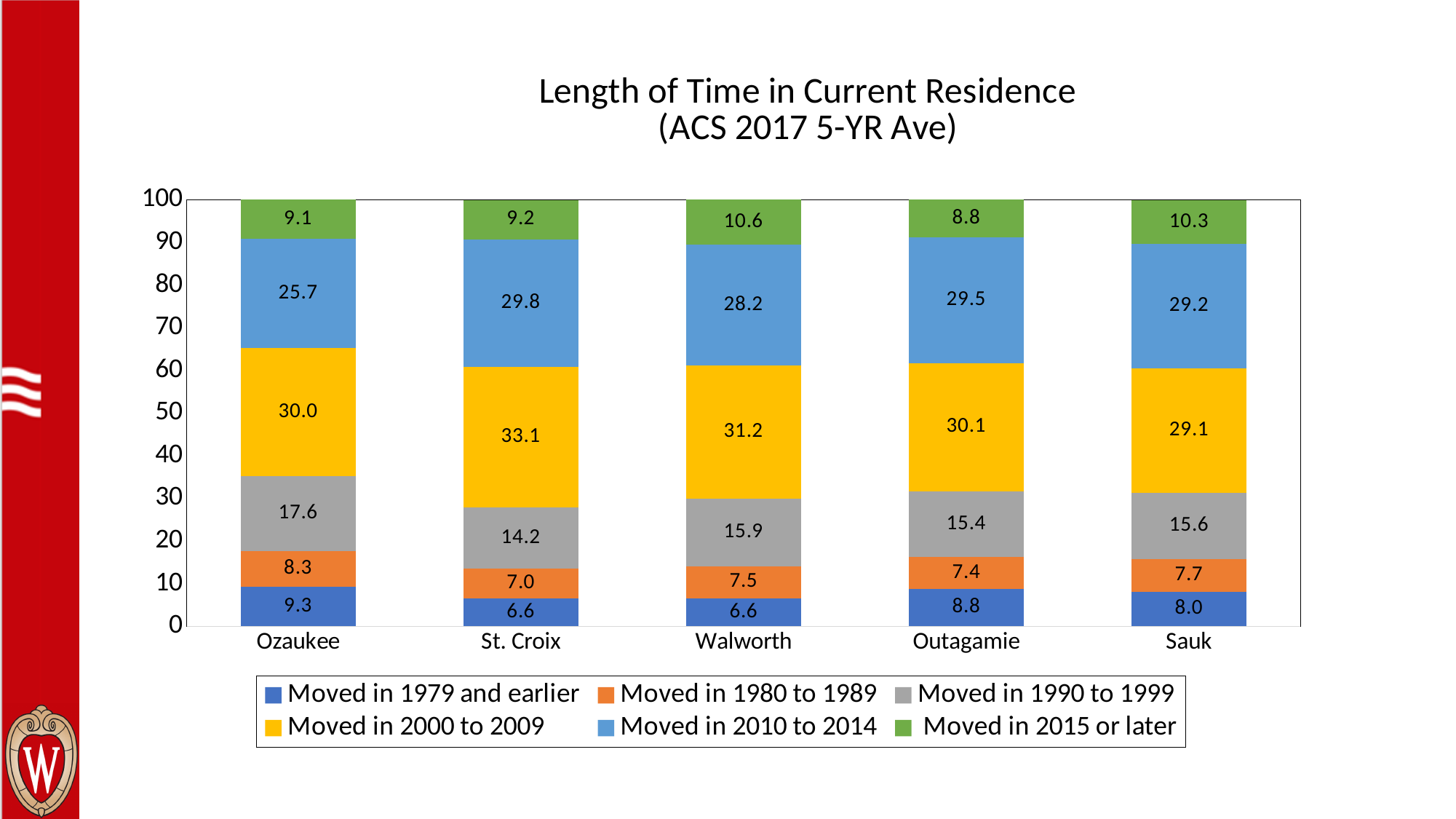
What kind of chart is shown on the slide? Stacked bar chart For Moved in 2010 to 2014, which is larger: St. Croix or Ozaukee? St. Croix What is the difference between the Moved in 1990 to 1999 values for Ozaukee and Sauk? 2.0 How many series does the legend list? 6 Which county has the highest value for Moved in 1979 and earlier? Ozaukee What is the value for Moved in 2015 or later in Walworth? 10.6 What is the value for Moved in 1990 to 1999 in Ozaukee? 17.6 Which county has the lowest value for Moved in 2015 or later? Outagamie What is the value for Moved in 2000 to 2009 in St. Croix? 33.1 In Walworth, what is the difference between the Moved in 2010 to 2014 value and the Moved in 1980 to 1989 value? 20.7 How many counties are shown on the x axis? 5 Which county has the highest value for Moved in 2000 to 2009? St. Croix